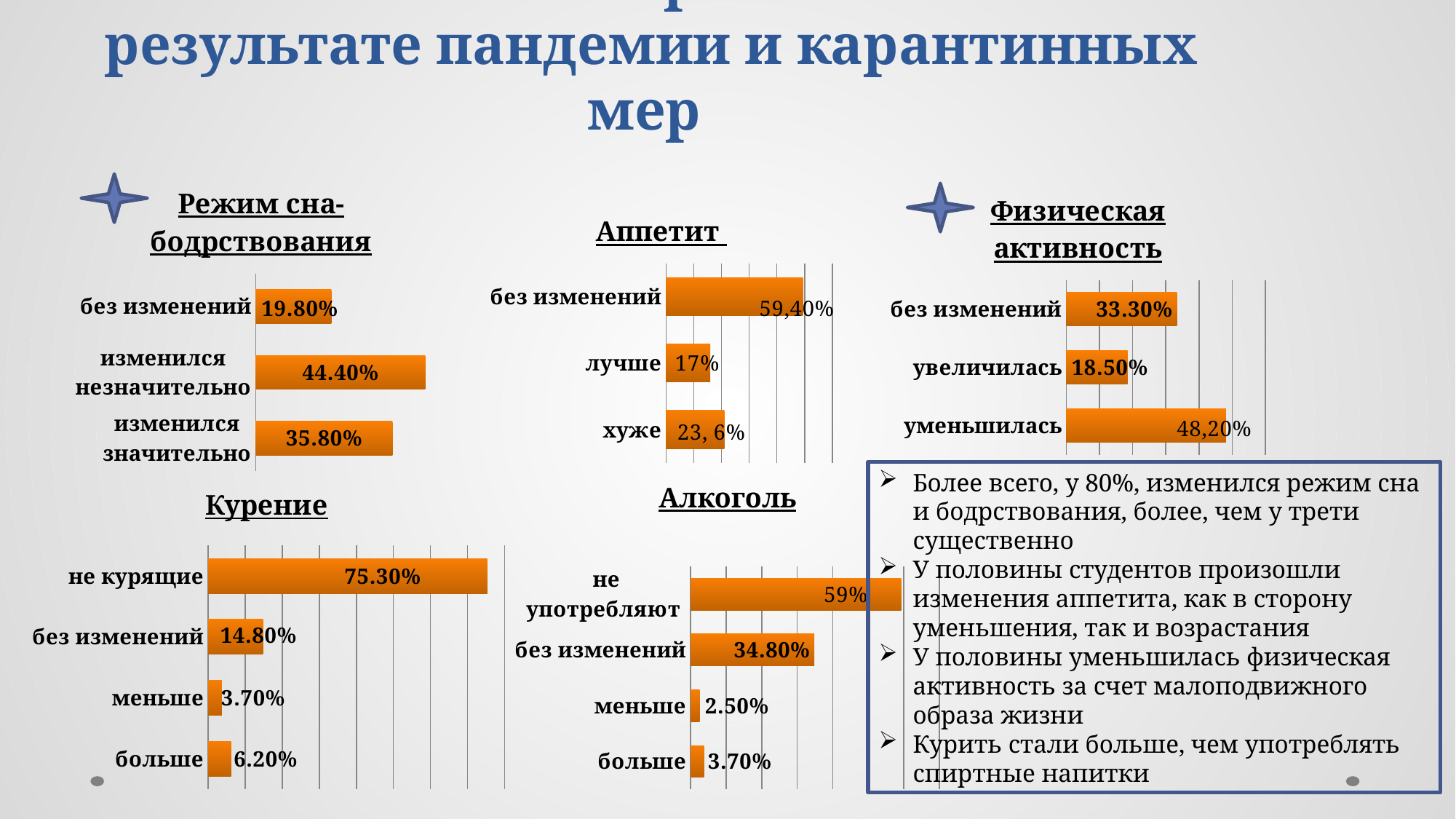
In the "Физическая активность" chart, what is the value for "увеличилась"? 18.50% In the "Режим сна-бодрствования" chart, what is the value for "изменился незначительно"? 44.40% In the "Физическая активность" chart, which category has the highest value? уменьшилась In the "Курение" chart, what is the difference between "больше" and "меньше"? 2.50% In the "Режим сна-бодрствования" chart, which category has the lowest value? без изменений In the "Аппетит" chart, what is the value for "без изменений"? 59,40% In the "Алкоголь" chart, which category has the lowest value? меньше In the "Аппетит" chart, which is larger, "лучше" or "хуже"? хуже In the "Курение" chart, how many categories are shown? 4 In the "Алкоголь" chart, what is the value for "без изменений"? 34.80% In the "Курение" chart, what is the value for "не курящие"? 75.30% What type of chart is the "Аппетит" chart? bar chart